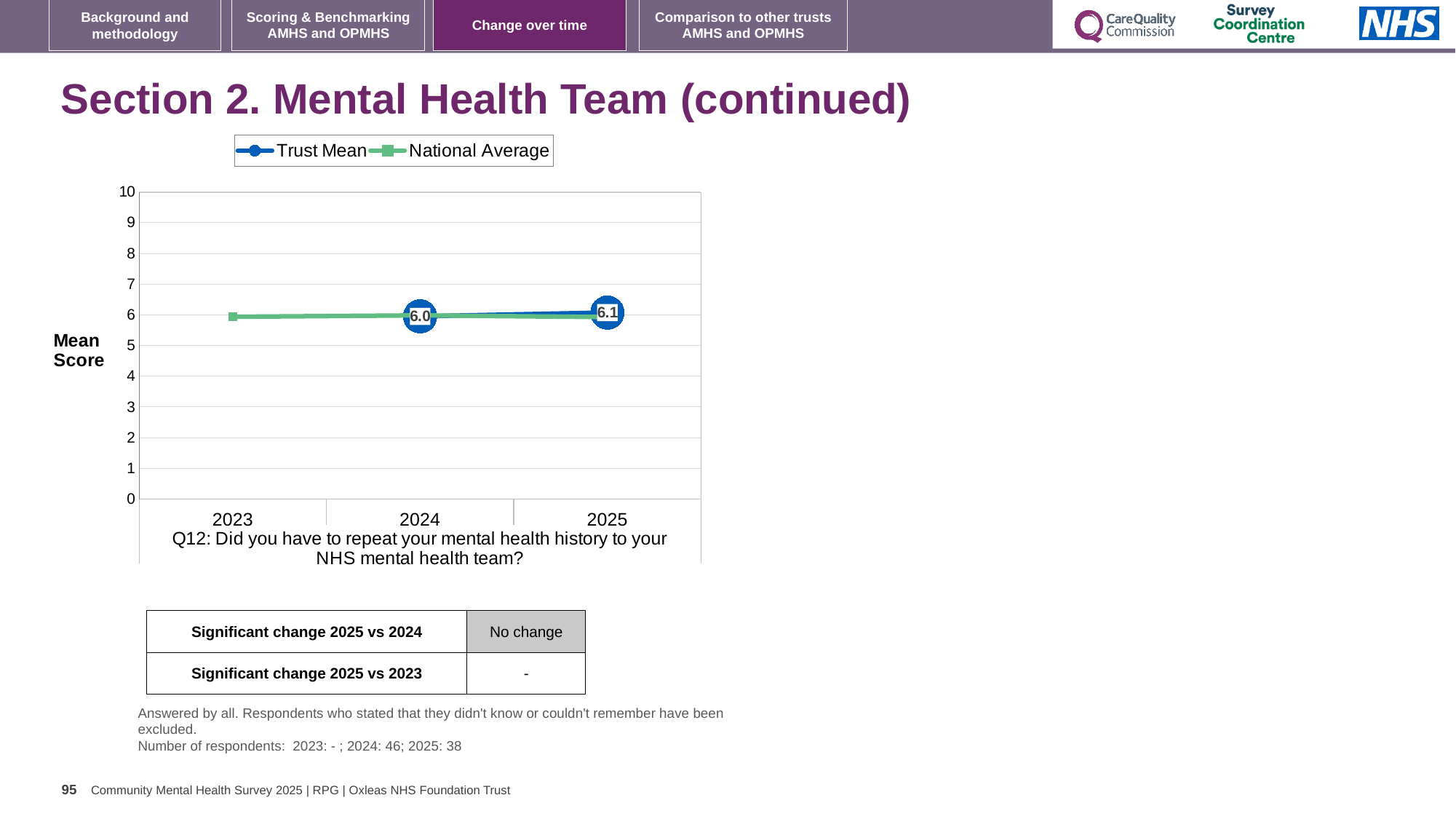
Which is larger, the Trust Mean for 2024 or for 2025? 2025 What is the label on the y axis of the chart? Mean Score How many years are shown on the x axis? 3 Is the National Average value for 2023 greater or less than 5? greater What is the Trust Mean value for 2025? 6.1 Does the Trust Mean rise or fall from 2024 to 2025? rise What is the difference between the Trust Mean in 2025 and in 2024? 0.1 What kind of chart is shown on the slide? line chart What is the Trust Mean value for 2024? 6.0 In which year is the Trust Mean highest? 2025 Is the National Average value for 2025 greater or less than 7? less How many series does the legend list? 2